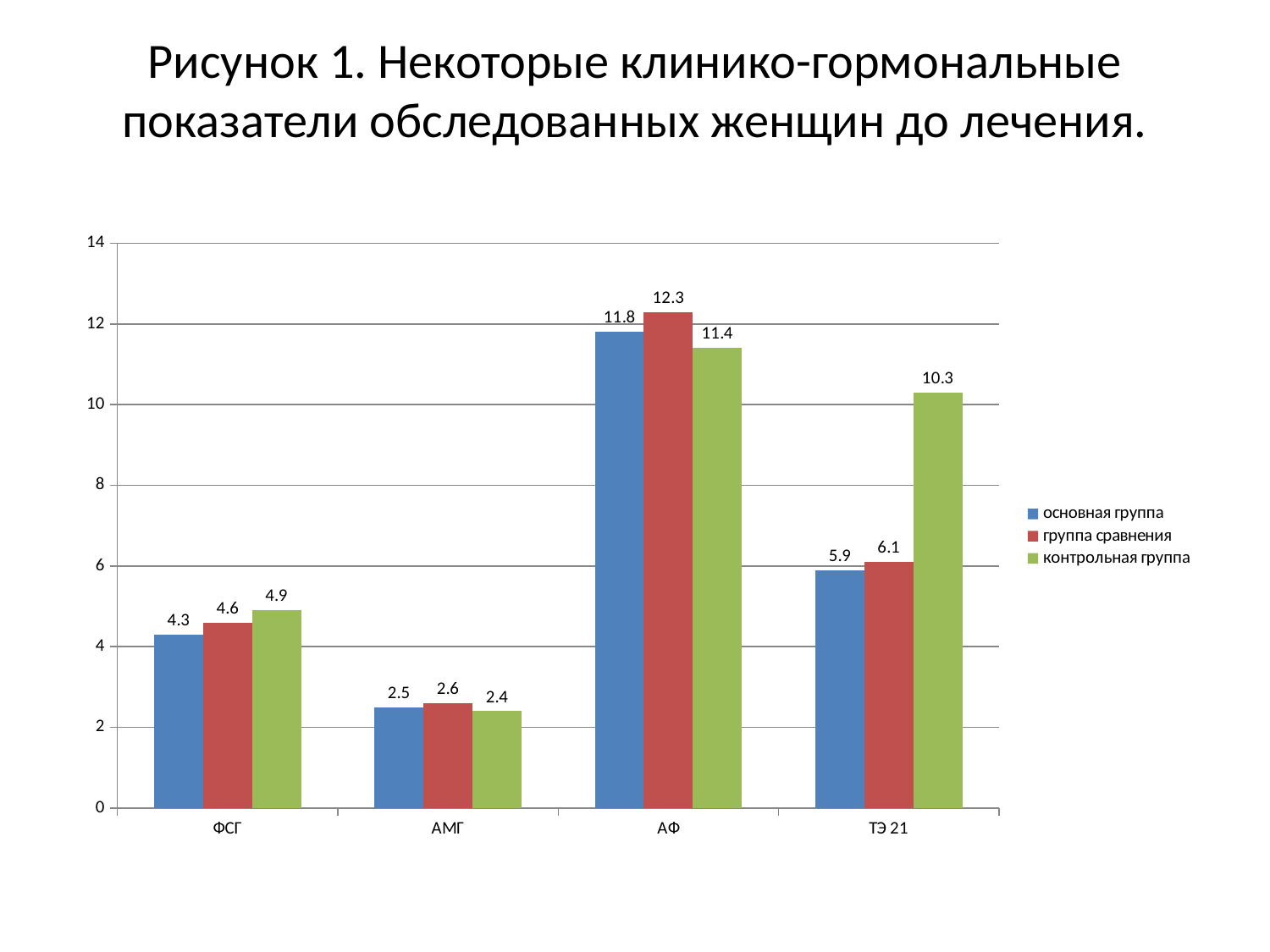
What kind of chart is shown on the slide? bar chart Which category has the highest value for основная группа? АФ What is the difference between контрольная группа and основная группа in the ТЭ 21 category? 4.4 Which series is shown in green in the legend? контрольная группа How many series does the legend list? 3 What is the value for основная группа in the ФСГ category? 4.3 Which category has the lowest value for контрольная группа? АМГ In the АФ category, which is larger: группа сравнения or контрольная группа? группа сравнения How many categories are shown on the x axis? 4 Is the value for контрольная группа in the ТЭ 21 category greater or less than 8? greater What is the value for группа сравнения in the АФ category? 12.3 What is the value for контрольная группа in the ТЭ 21 category? 10.3